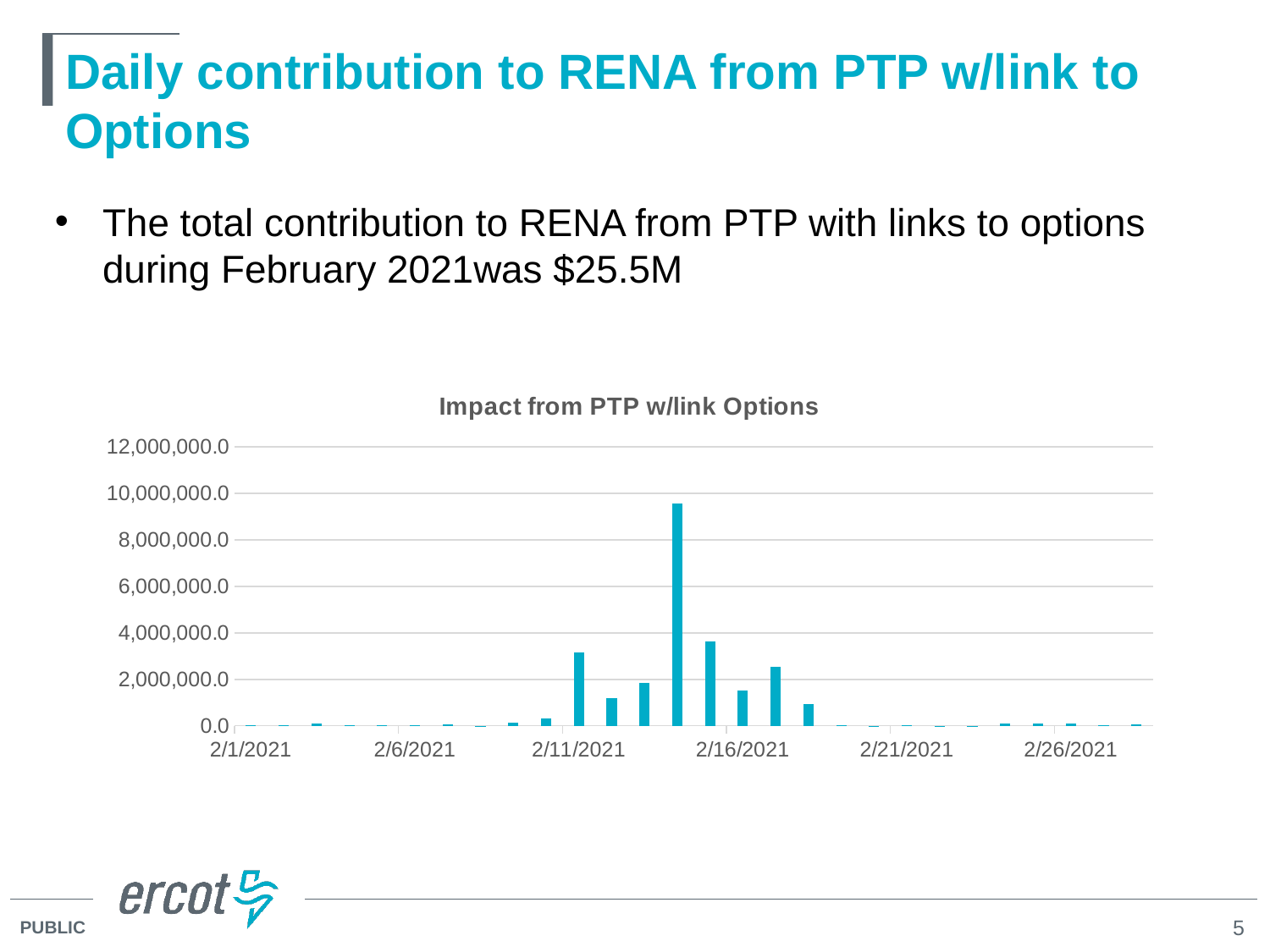
Is the tallest bar on the chart greater or less than 8,000,000.0? greater Is the value for 2/16/2021 greater or less than 2,000,000.0? less Which has the larger value, 2/11/2021 or 2/16/2021? 2/11/2021 What is the highest value shown on the chart's y axis? 12,000,000.0 What is the title of the chart? Impact from PTP w/link Options Do the values peak in the middle of the month or at the end of the month? Middle of the month Is the value for 2/1/2021 greater or less than 2,000,000.0? less Does the tallest bar fall between 2/11/2021 and 2/16/2021, or between 2/21/2021 and 2/26/2021? Between 2/11/2021 and 2/16/2021 Which has the larger value, 2/11/2021 or 2/26/2021? 2/11/2021 What kind of chart is shown on the slide? Bar chart